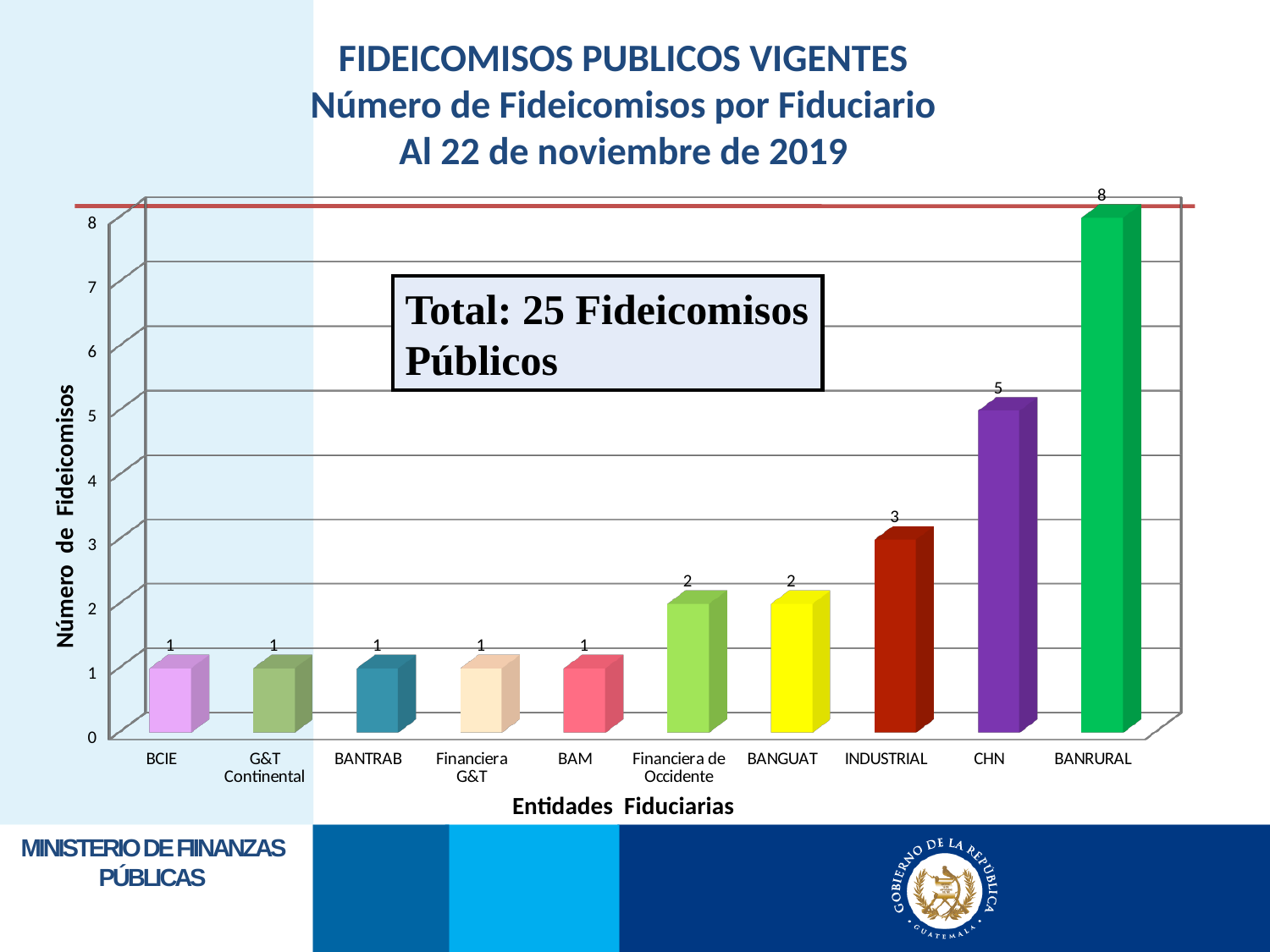
What type of chart is shown on the slide? Bar chart What total is stated in the text box on the chart? Total: 25 Fideicomisos Públicos How many fideicomisos does BANRURAL have? 8 What is the label of the y axis? Número de Fideicomisos Which has a larger value, INDUSTRIAL or BANGUAT? INDUSTRIAL Which entity has the highest number of fideicomisos? BANRURAL How many entities have a value of 1? 5 How many entities (categories) are shown on the x axis? 10 What is the value shown for INDUSTRIAL? 3 Do the values generally rise or fall from left to right along the x axis? Rise What is the value shown for CHN? 5 What is the difference between the values for BANRURAL and CHN? 3